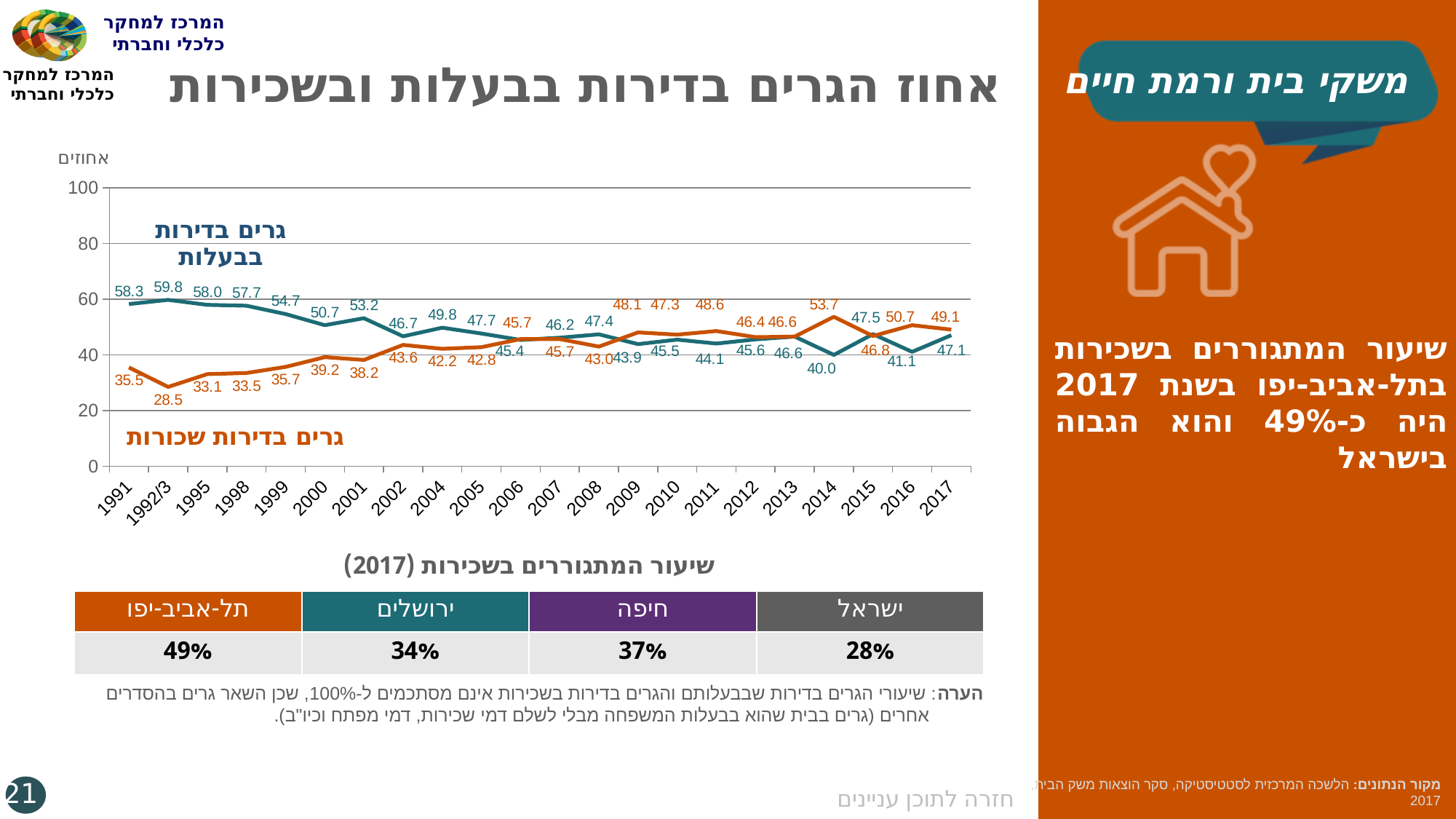
What is the value for גרים בדירות שכורות in 2017? 49.1 How many years are shown on the x axis of the line chart? 22 What type of chart is shown on the slide? line chart How many series are plotted in the line chart? 2 What is the value for גרים בדירות בבעלות in 1991? 58.3 Which series has the larger value in 2016, גרים בדירות בבעלות or גרים בדירות שכורות? גרים בדירות שכורות In which year is the value for גרים בדירות בבעלות the highest? 1992/3 What is the value for גרים בדירות בבעלות in 2014? 40.0 Does the value for גרים בדירות בבעלות generally rise or fall from 1991 to 2017? fall What is the difference between גרים בדירות בבעלות and גרים בדירות שכורות in 1991? 22.8 In which year is the value for גרים בדירות שכורות the lowest? 1992/3 In which year is the value for גרים בדירות שכורות the highest? 2014